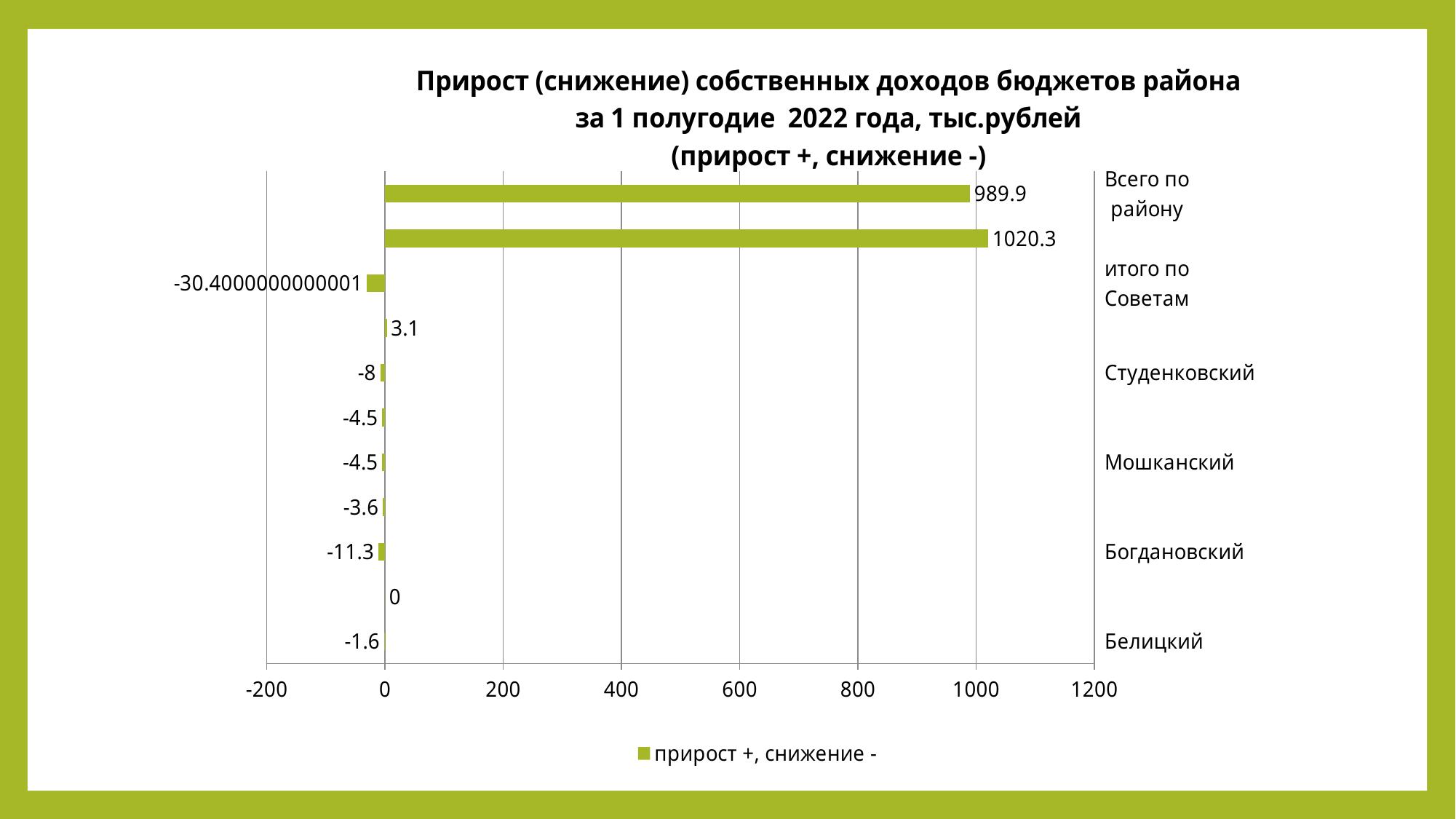
What kind of chart is shown on the slide? Bar chart What is the legend entry of the chart? прирост +, снижение - What is the difference between the two largest values, 1020.3 and 989.9? 30.4 Which is larger, the value for Богдановский or the value for Белицкий? Белицкий What is the value for Всего по району? 989.9 How many bars are plotted in the chart? 11 What is the lowest value shown in the chart, as printed on its data label? -30.4000000000001 What is the value for Студенковский? -8 How many series does the legend list? 1 What is the value for Белицкий? -1.6 What is the largest value shown in the chart? 1020.3 What is the value for Богдановский? -11.3